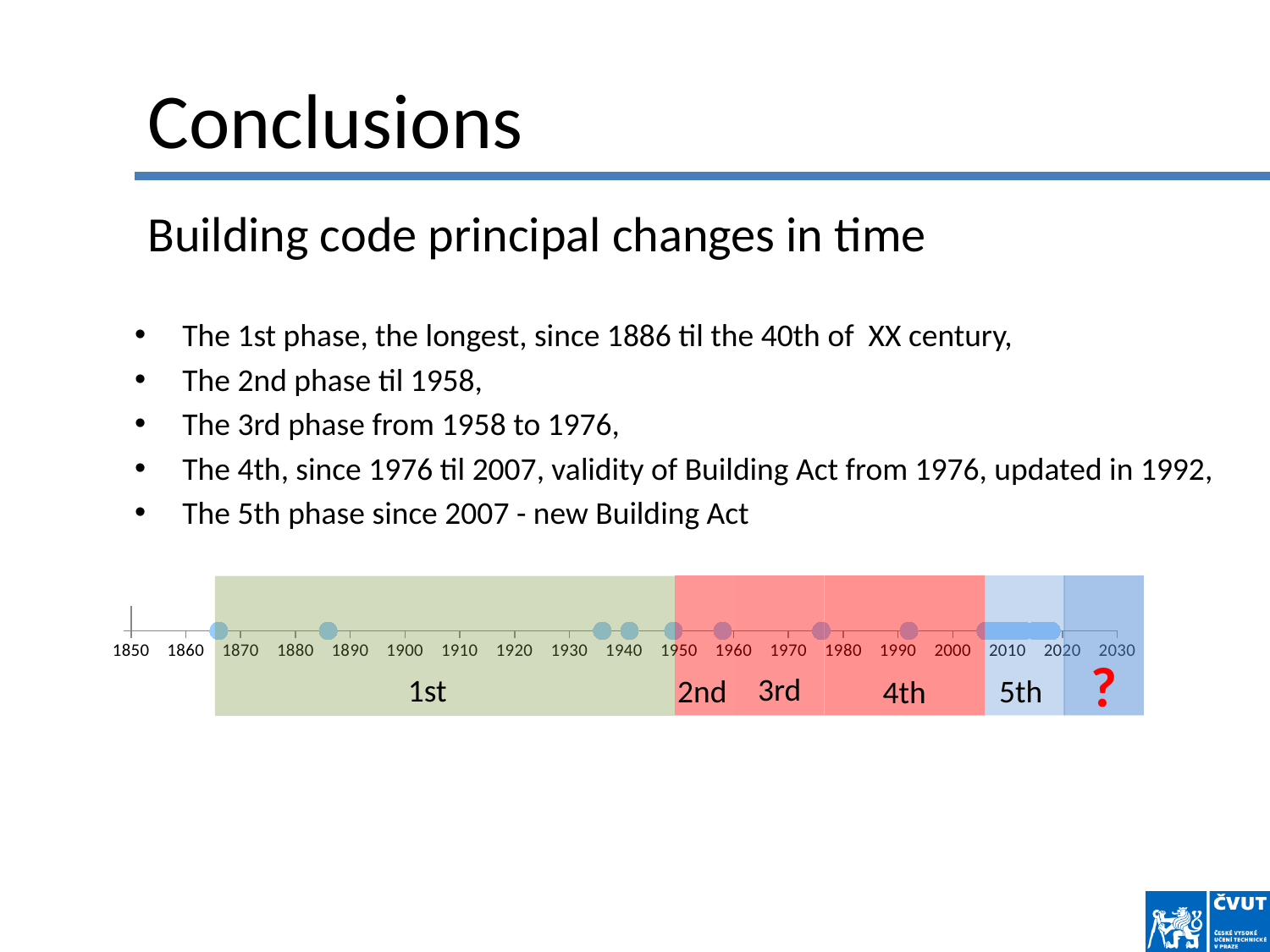
What is the last year tick shown on the timeline axis? 2030 Which phase band on the timeline contains the year 1990? 4th Does the 4th phase band on the timeline end before or after the year 2000? after What label appears in the last (rightmost) band of the timeline after the 5th phase? ? What kind of chart is shown at the bottom of the slide? A timeline Which phase occupies the longest span on the timeline? 1st Which labelled phase occupies the shortest span on the timeline? 2nd What colour is the band for the 1st phase on the timeline? Green Which phase band on the timeline contains the year 1970? 3rd How many numbered phases are labelled on the timeline chart? 5 Which phase band on the timeline contains the year 1920? 1st What is the first year tick shown on the timeline axis? 1850